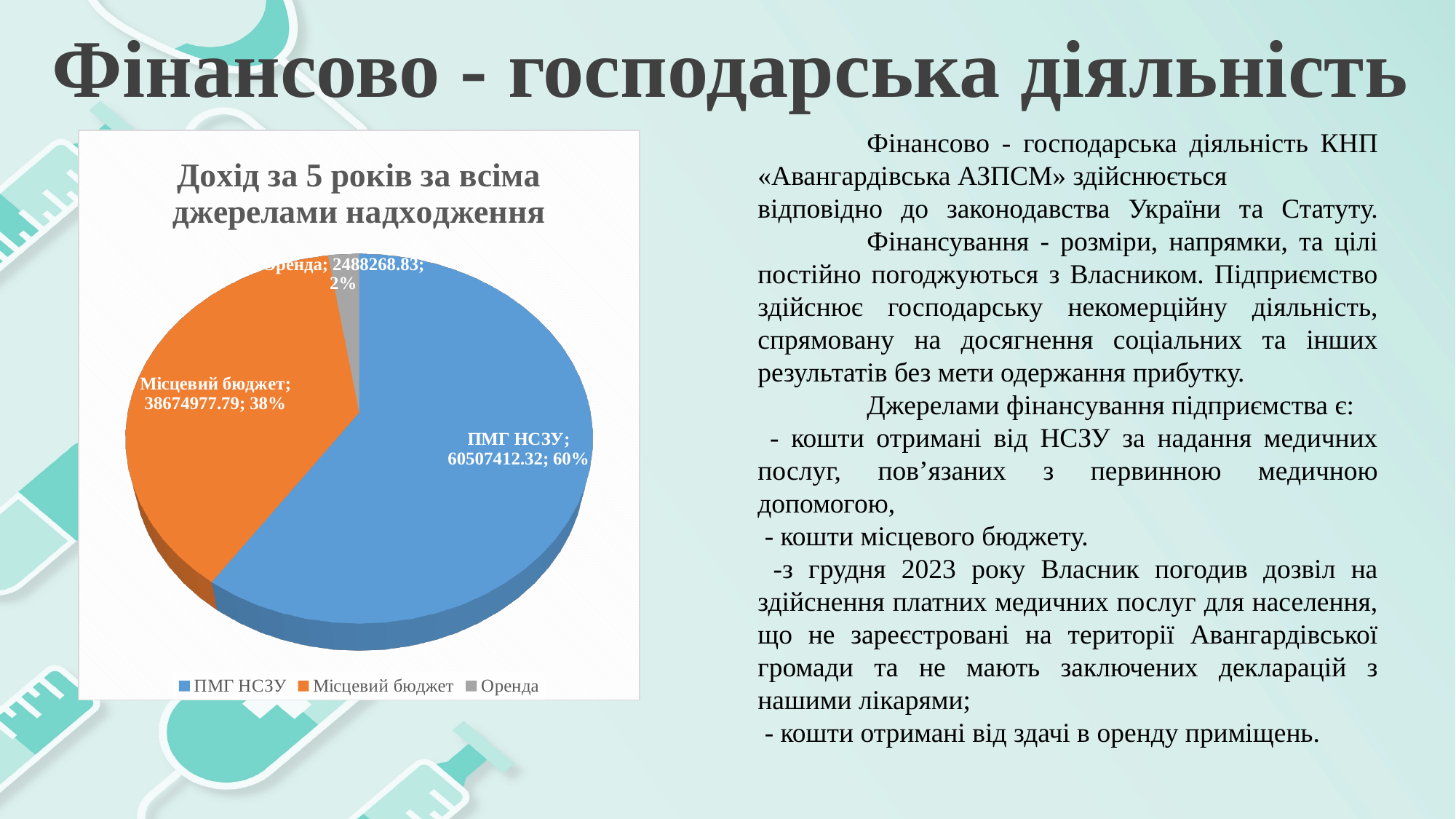
What share of the pie does ПМГ НСЗУ represent? 60% What is the difference between the values for ПМГ НСЗУ and Місцевий бюджет? 21832434.53 What is the value for Місцевий бюджет? 38674977.79 What share of the pie does Оренда represent? 2% Which category has the largest slice? ПМГ НСЗУ What type of chart is shown on the slide? pie chart What is the title of the chart? Дохід за 5 років за всіма джерелами надходження What is the value for ПМГ НСЗУ? 60507412.32 Which category has the smallest slice? Оренда What is the value for Оренда? 2488268.83 How many slices does the pie chart have? 3 How many entries does the legend list? 3